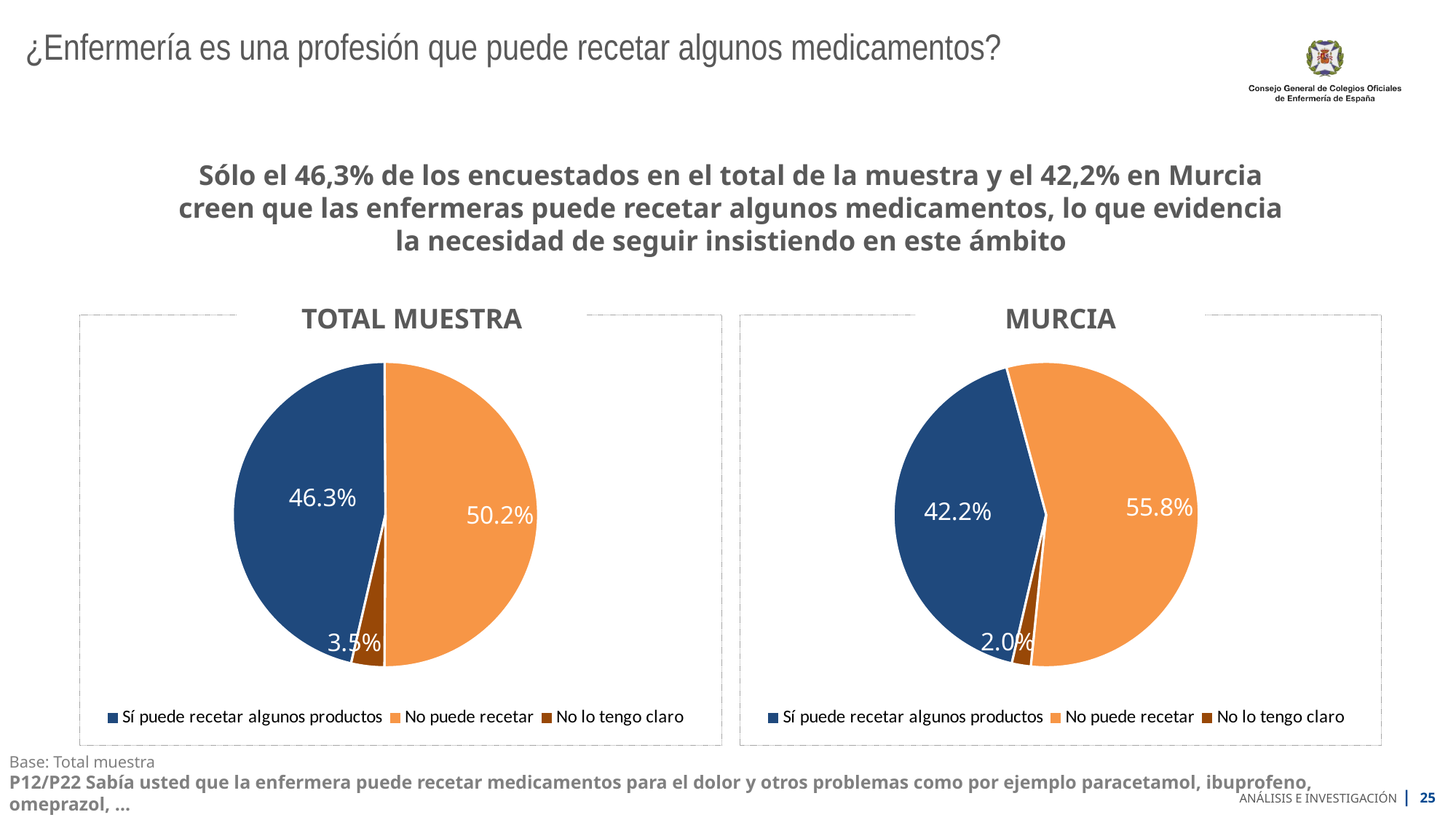
In the MURCIA chart, what percentage corresponds to 'Sí puede recetar algunos productos'? 42.2% In the TOTAL MUESTRA chart, what percentage corresponds to 'Sí puede recetar algunos productos'? 46.3% What type of chart is used in the TOTAL MUESTRA chart? Pie chart How many categories does the legend of the MURCIA chart list? 3 In the MURCIA chart, what percentage corresponds to 'No lo tengo claro'? 2.0% In the TOTAL MUESTRA chart, what percentage corresponds to 'No puede recetar'? 50.2% In the MURCIA chart, what is the difference between 'No puede recetar' and 'Sí puede recetar algunos productos'? 13.6% Which is larger: 'Sí puede recetar algunos productos' in the TOTAL MUESTRA chart or in the MURCIA chart? TOTAL MUESTRA In the MURCIA chart, what percentage corresponds to 'No puede recetar'? 55.8% In the TOTAL MUESTRA chart, which category has the smallest share? No lo tengo claro In the MURCIA chart, which category has the largest share? No puede recetar In the TOTAL MUESTRA chart, what percentage corresponds to 'No lo tengo claro'? 3.5%